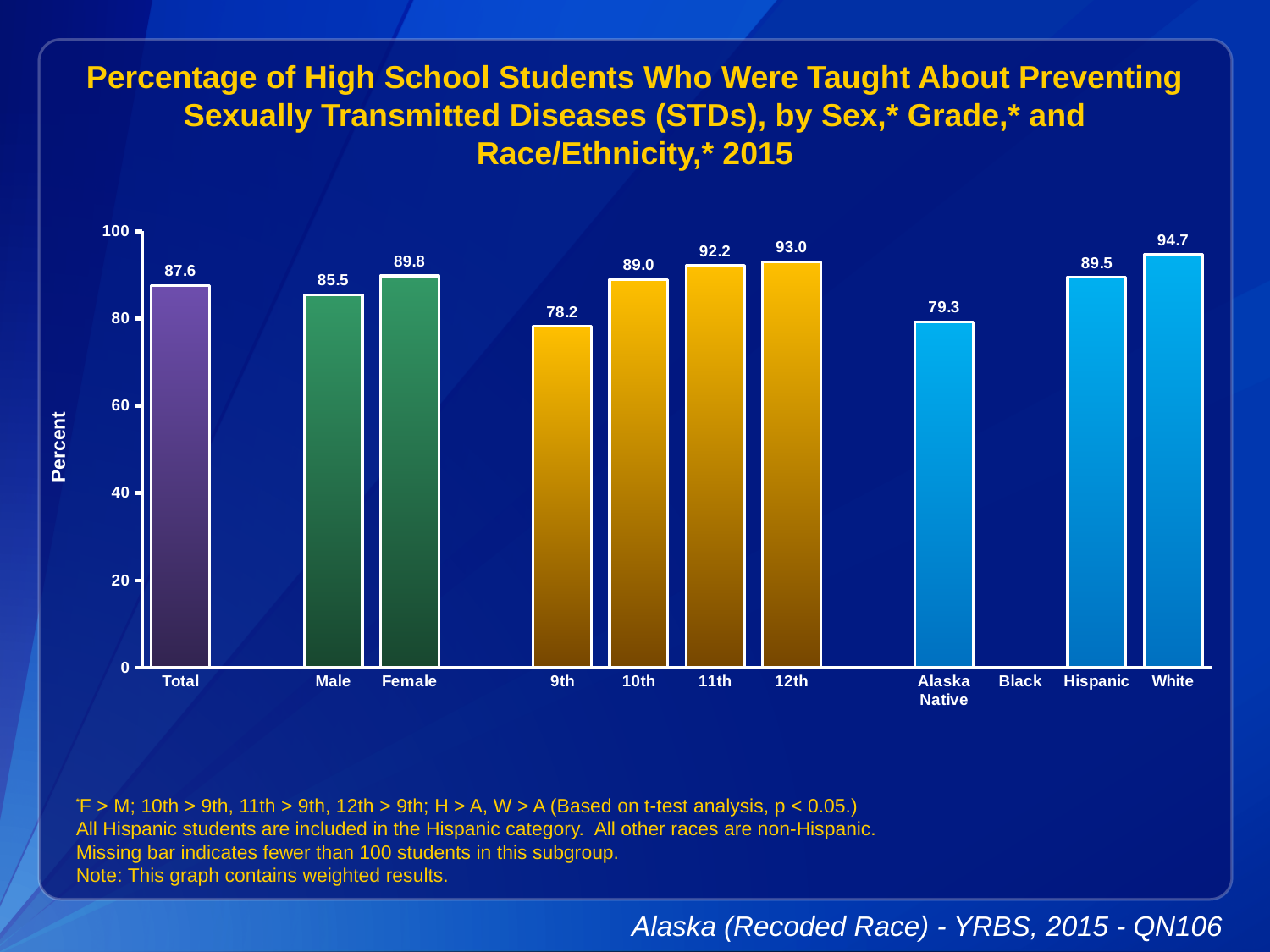
What is the difference between the Female and Male values? 4.3 What is the value for Alaska Native? 79.3 What is the difference between the 12th grade and 9th grade values? 14.8 What kind of chart is shown? bar chart Which category label has no bar plotted? Black Which category with a plotted bar has the lowest value? 9th What is the value for Female? 89.8 What is the value for 9th grade? 78.2 Which category has the highest value? White Which is larger, the value for Hispanic or the value for Alaska Native? Hispanic Do the values rise or fall from 9th grade to 12th grade? rise What is the value for Total? 87.6